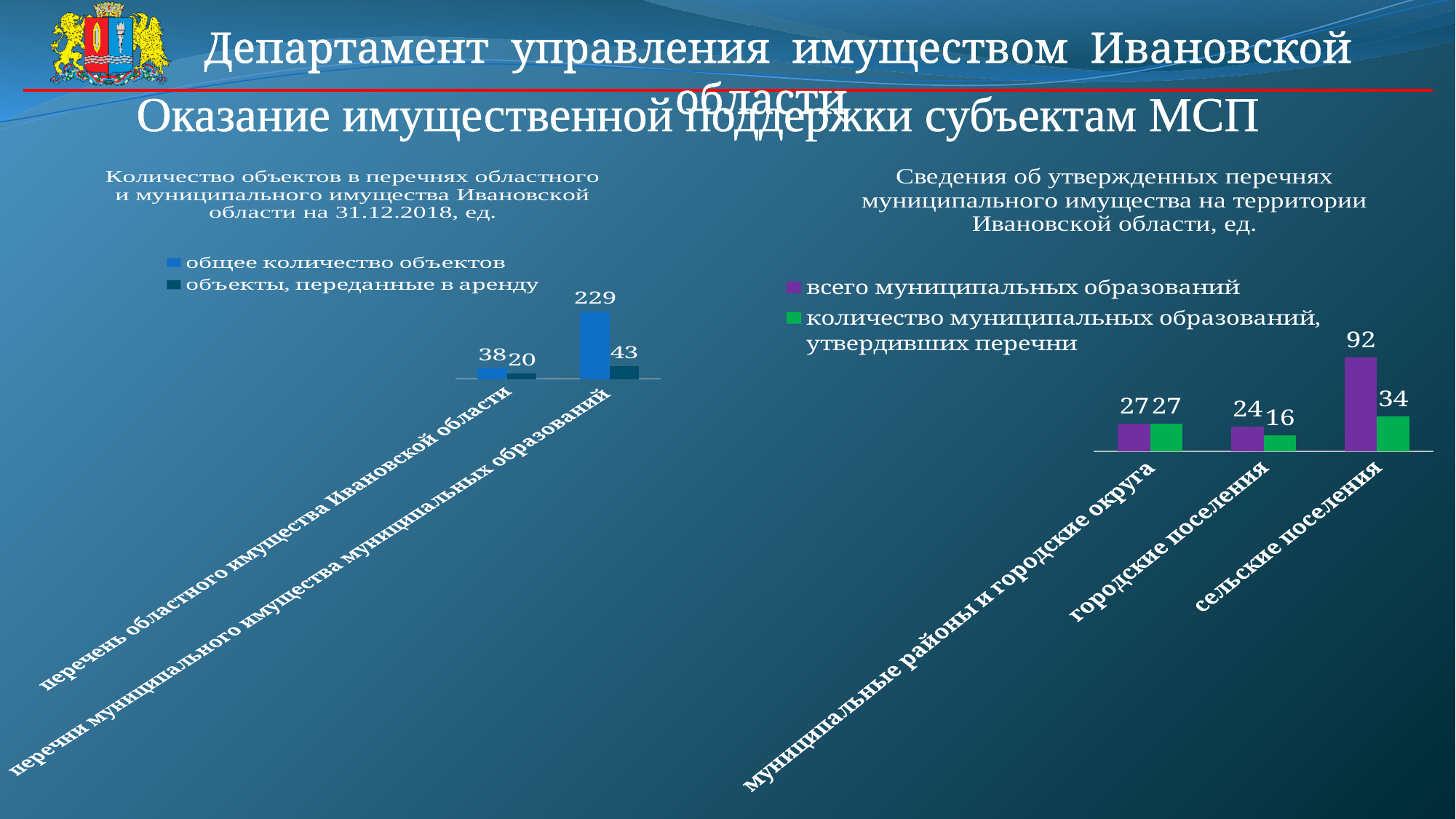
In the left chart (Количество объектов в перечнях...), what is the value of 'общее количество объектов' for 'перечни муниципального имущества муниципальных образований'? 229 In the right chart (Сведения об утвержденных перечнях...), which category has the lowest value of 'количество муниципальных образований, утвердивших перечни'? городские поселения In the left chart (Количество объектов в перечнях...), what is the difference between 'общее количество объектов' and 'объекты, переданные в аренду' for 'перечни муниципального имущества муниципальных образований'? 186 In the right chart (Сведения об утвержденных перечнях...), what is the value of 'количество муниципальных образований, утвердивших перечни' for 'городские поселения'? 16 In the right chart (Сведения об утвержденных перечнях...), what is the difference between 'всего муниципальных образований' and 'количество муниципальных образований, утвердивших перечни' for 'сельские поселения'? 58 In the left chart (Количество объектов в перечнях...), how many series does the legend list? 2 In the right chart (Сведения об утвержденных перечнях...), how many categories are shown on the x axis? 3 In the left chart (Количество объектов в перечнях...), what kind of chart is shown? Bar chart In the right chart (Сведения об утвержденных перечнях...), which category has the highest value of 'всего муниципальных образований'? сельские поселения In the right chart (Сведения об утвержденных перечнях...), which colour represents 'всего муниципальных образований'? Purple In the left chart (Количество объектов в перечнях...), what is the value of 'объекты, переданные в аренду' for 'перечень областного имущества Ивановской области'? 20 In the right chart (Сведения об утвержденных перечнях...), what is the value of 'всего муниципальных образований' for 'сельские поселения'? 92